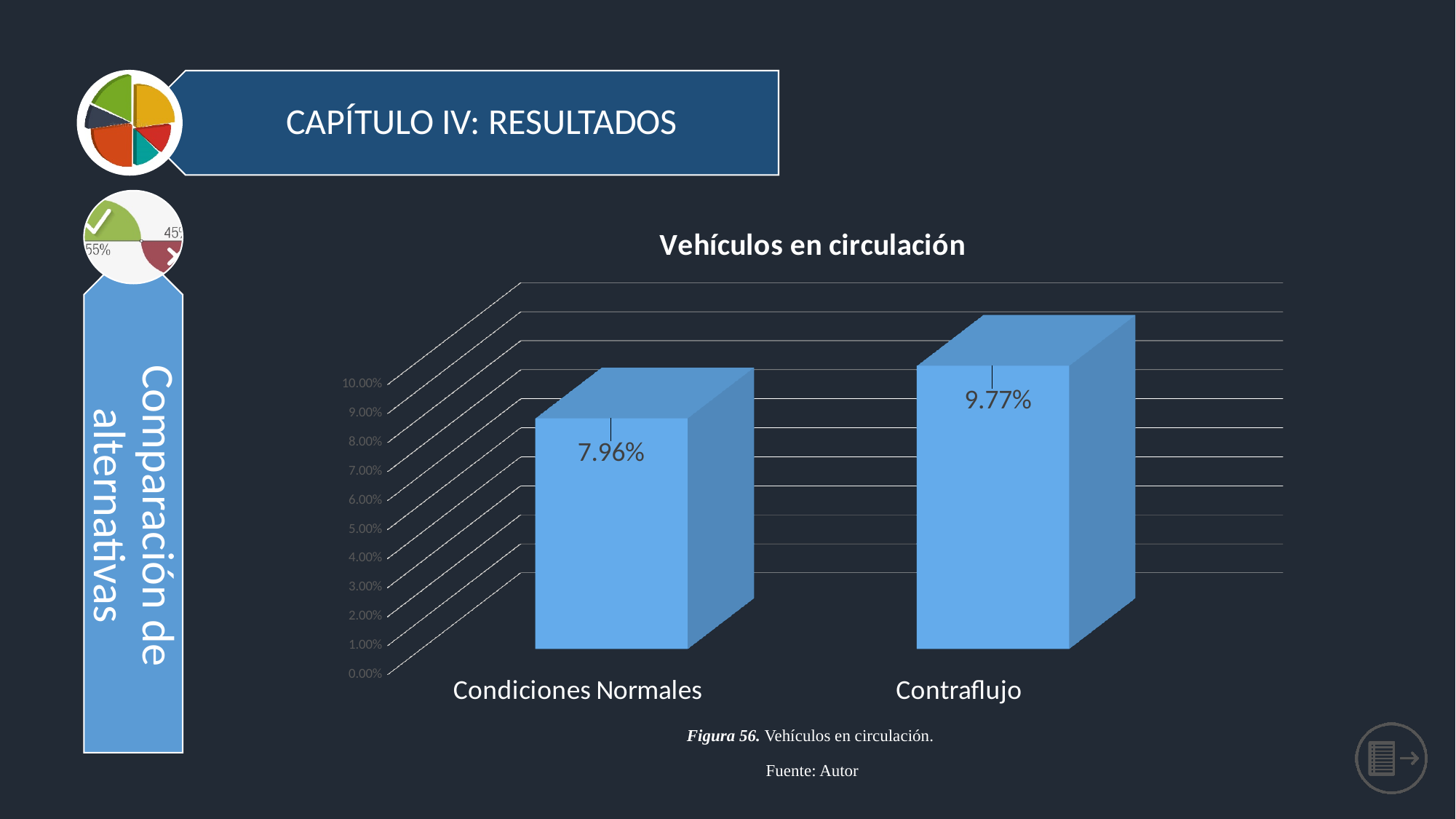
What is the title of the chart? Vehículos en circulación How many categories are shown in the chart? 2 Is the value for Contraflujo greater or less than 9.00%? greater Is the value for Condiciones Normales greater or less than 8.00%? less What is the value for Condiciones Normales? 7.96% What is the difference between the values for Contraflujo and Condiciones Normales? 1.81% Which category has the lowest value? Condiciones Normales Which category has the highest value? Contraflujo Which is larger, the value for Condiciones Normales or the value for Contraflujo? Contraflujo Do the values rise or fall from Condiciones Normales to Contraflujo? Rise What kind of chart is shown on the slide? Bar chart What is the value for Contraflujo? 9.77%